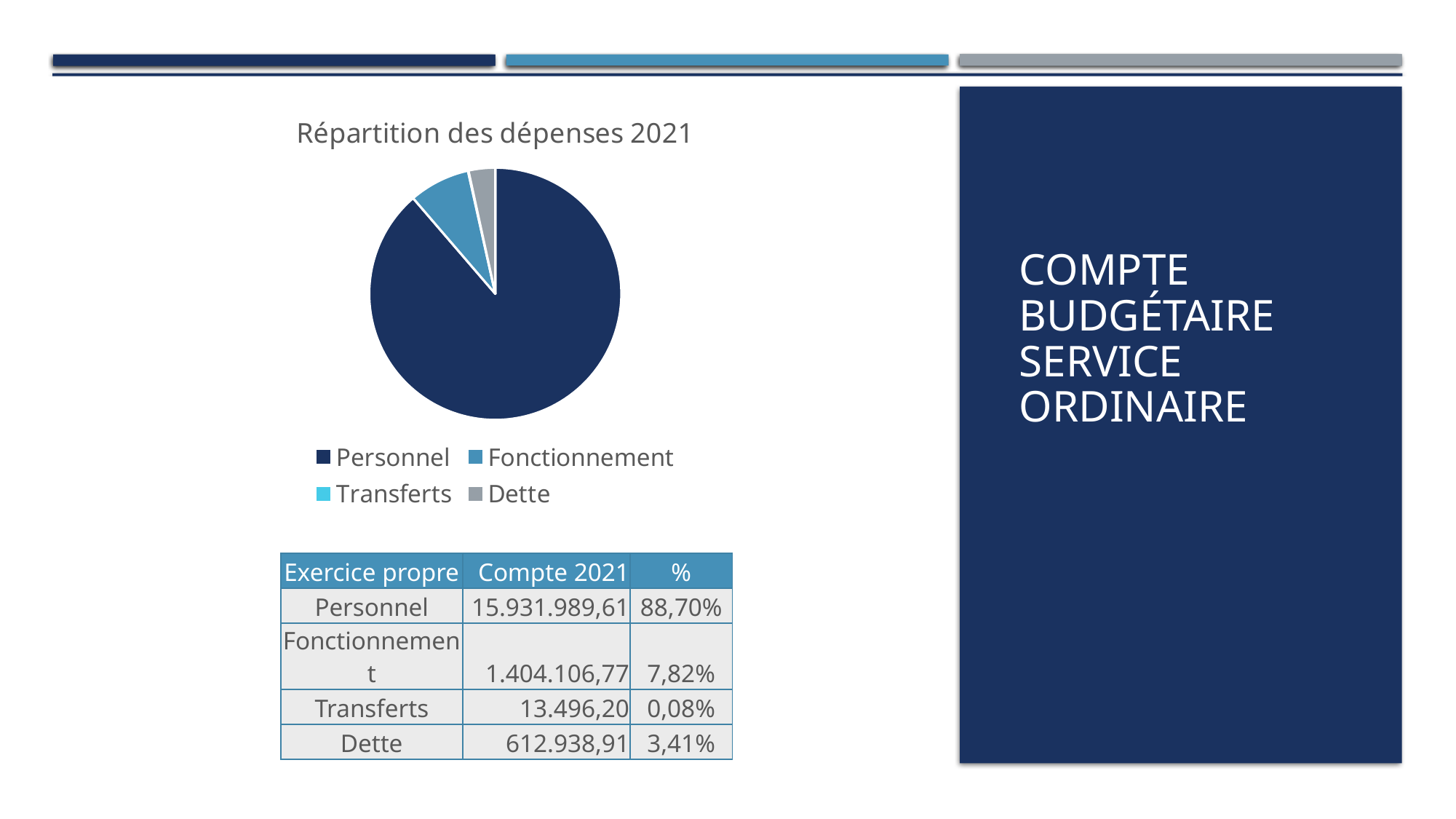
According to the table on the slide, what share of the 2021 expenses does Dette represent? 3,41% According to the table on the slide, what is the Compte 2021 value for Fonctionnement? 1.404.106,77 According to the table on the slide, what share of the 2021 expenses does Personnel represent? 88,70% Which category has the largest slice in the pie chart "Répartition des dépenses 2021"? Personnel How many slices does the pie chart "Répartition des dépenses 2021" have? 4 In the pie chart, which slice is larger: Fonctionnement or Dette? Fonctionnement According to the table on the slide, what is the Compte 2021 value for Dette? 612.938,91 What kind of chart is shown under the title "Répartition des dépenses 2021"? pie chart How many entries does the legend of the pie chart list? 4 Which category has the smallest slice in the pie chart "Répartition des dépenses 2021"? Transferts What colour is the Personnel slice in the pie chart? dark blue What is the title of the pie chart on the slide? Répartition des dépenses 2021